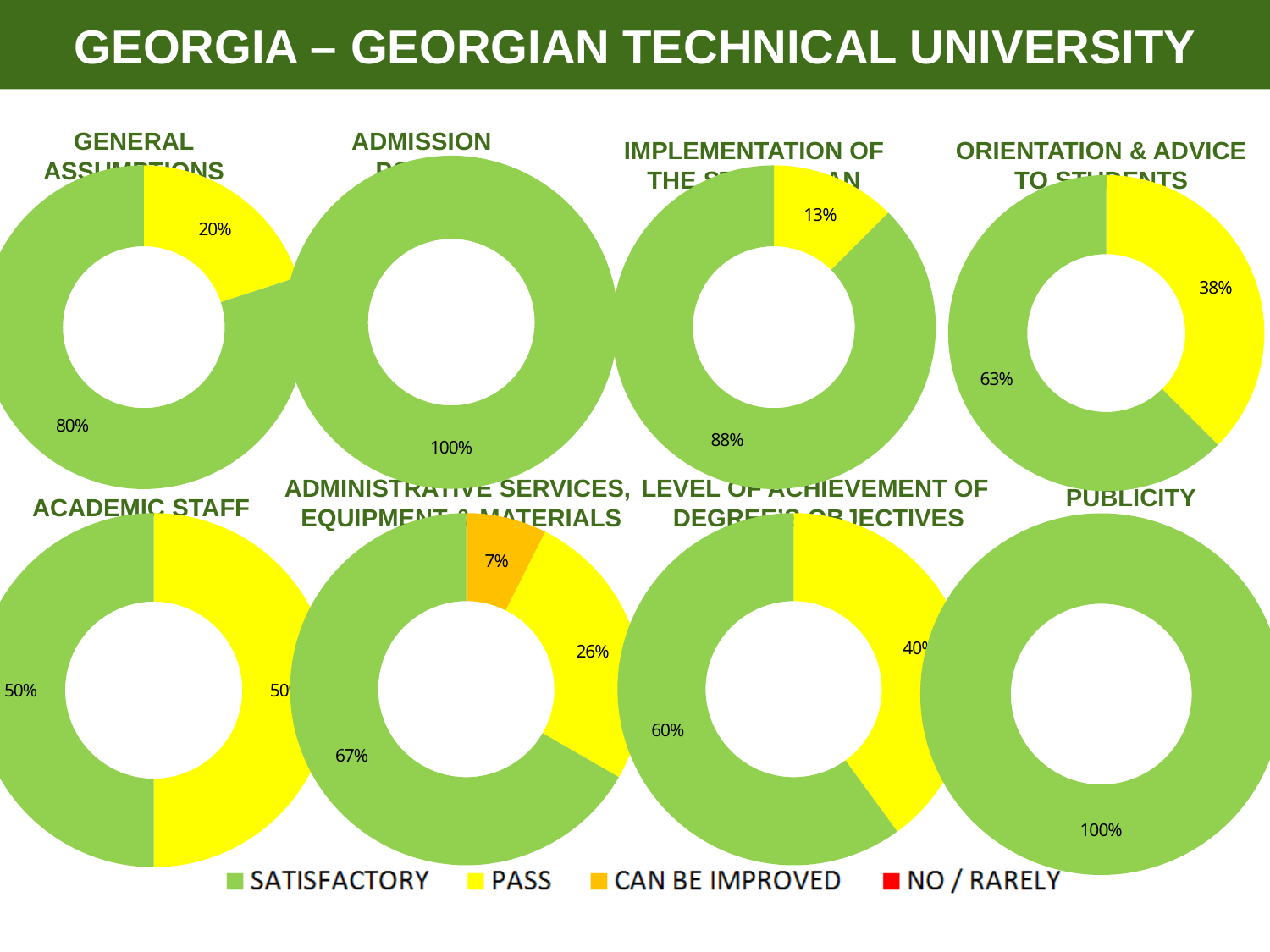
In the ADMINISTRATIVE SERVICES, EQUIPMENT & MATERIALS chart, which category has the largest share? SATISFACTORY In the ADMINISTRATIVE SERVICES, EQUIPMENT & MATERIALS chart, what is the difference between the SATISFACTORY share and the PASS share? 41% In the ADMINISTRATIVE SERVICES, EQUIPMENT & MATERIALS chart, what share is labelled CAN BE IMPROVED (orange)? 7% In the GENERAL ASSUMPTIONS chart, what share is labelled PASS (yellow)? 20% What kind of chart is the PUBLICITY chart? Doughnut chart In the LEVEL OF ACHIEVEMENT OF DEGREE'S OBJECTIVES chart, what is the SATISFACTORY share? 60% In the ACADEMIC STAFF chart, what is the SATISFACTORY share? 50% In the ORIENTATION & ADVICE TO STUDENTS chart, what is the SATISFACTORY share? 63% How many entries does the shared legend at the bottom of the slide list? 4 In the GENERAL ASSUMPTIONS chart, what share is labelled SATISFACTORY (green)? 80% In the ORIENTATION & ADVICE TO STUDENTS chart, what is the PASS share? 38% In the PUBLICITY chart, what share is labelled SATISFACTORY? 100%